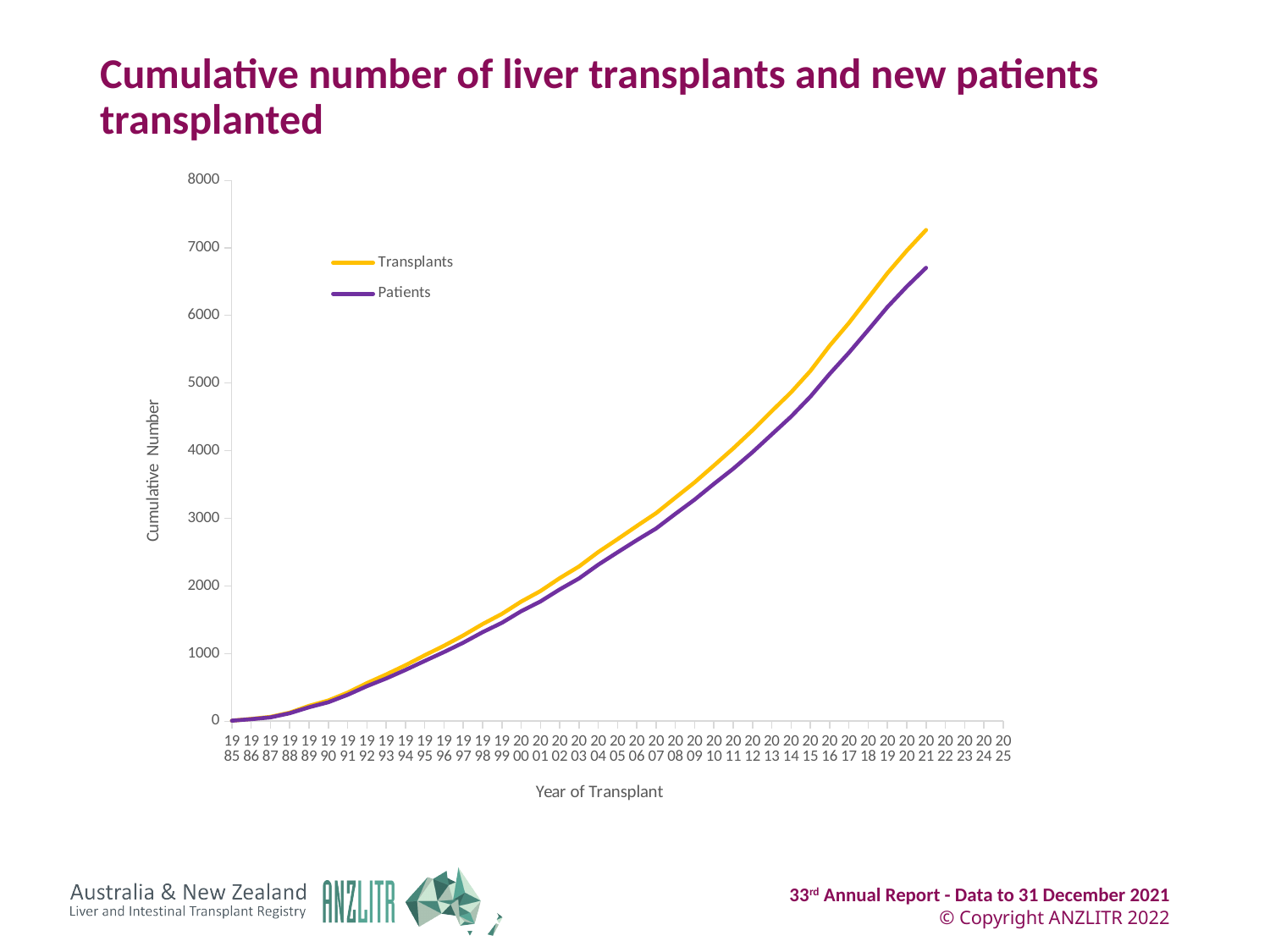
Is the cumulative number of Patients in 2010 greater or less than 3000? greater What is the label of the y axis? Cumulative Number What kind of chart is shown on the slide? line chart Is the cumulative number of Transplants in 2000 greater or less than 2000? less Is the cumulative number of Transplants in 2021 greater or less than 7000? greater In 2021, which series has the higher cumulative number, Transplants or Patients? Transplants Do the Patients values rise or fall as the year increases along the x axis? rise What are the two series named in the legend? Transplants and Patients How many series does the legend list? 2 Do the Transplants values rise or fall as the year increases along the x axis? rise